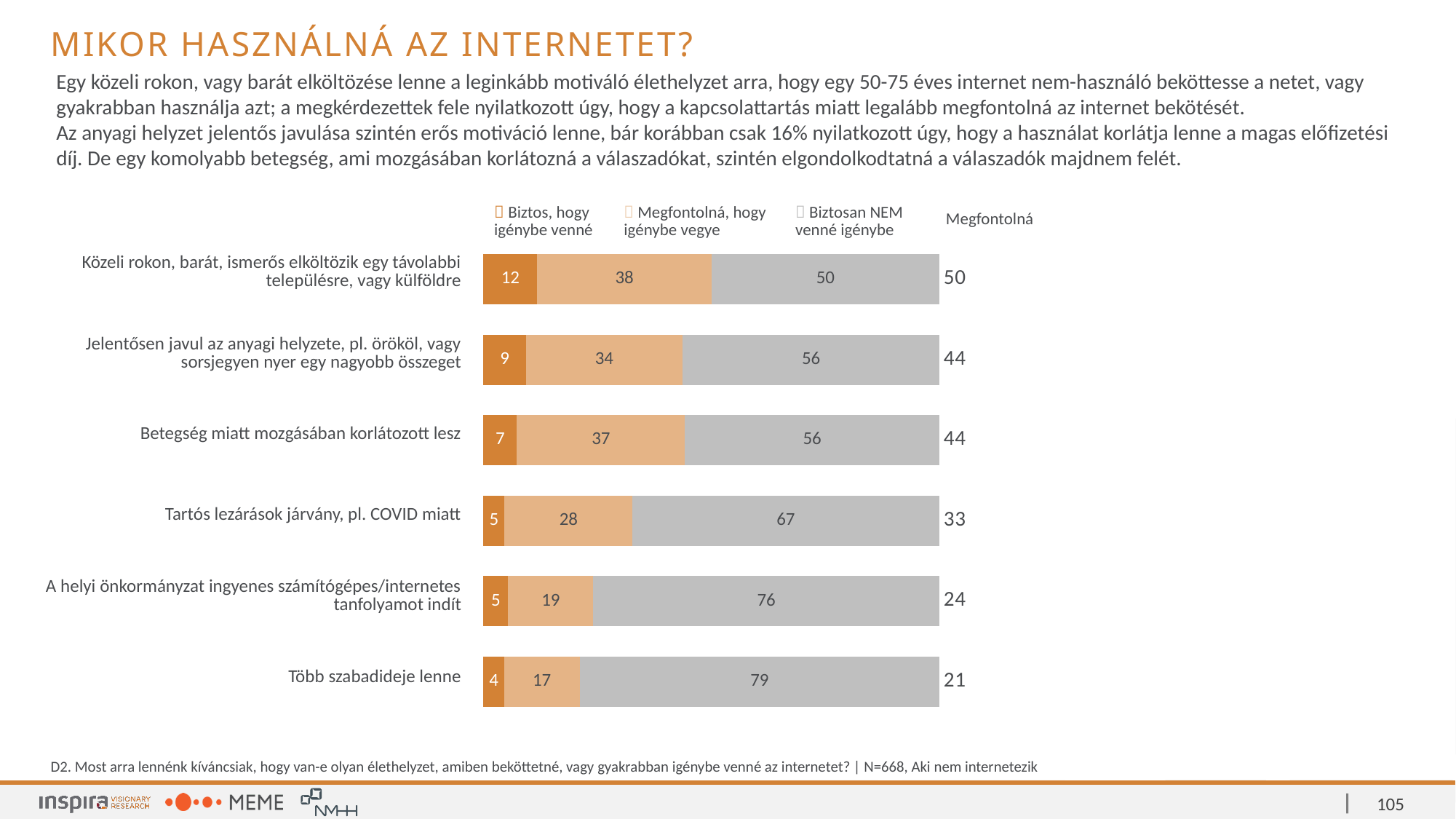
What is the 'Biztosan NEM venné igénybe' value for 'Tartós lezárások járvány, pl. COVID miatt'? 67 How many categories (life situations) are shown in the chart? 6 What is the 'Megfontolná' total shown to the right of the bar for 'A helyi önkormányzat ingyenes számítógépes/internetes tanfolyamot indít'? 24 What kind of chart is shown on the slide? Stacked bar chart What is the title of the slide containing the chart? MIKOR HASZNÁLNÁ AZ INTERNETET? What is the difference between the 'Biztosan NEM venné igénybe' values for 'Több szabadideje lenne' and 'Közeli rokon, barát, ismerős elköltözik egy távolabbi településre, vagy külföldre'? 29 What is the 'Megfontolná, hogy igénybe vegye' value for 'Több szabadideje lenne'? 17 Which is larger: the 'Megfontolná, hogy igénybe vegye' value for 'Betegség miatt mozgásában korlátozott lesz' or for 'Jelentősen javul az anyagi helyzete, pl. örököl, vagy sorsjegyen nyer egy nagyobb összeget'? Betegség miatt mozgásában korlátozott lesz Which category has the highest 'Biztosan NEM venné igénybe' value? Több szabadideje lenne What is the 'Biztos, hogy igénybe venné' value for 'Közeli rokon, barát, ismerős elköltözik egy távolabbi településre, vagy külföldre'? 12 Which category has the lowest 'Megfontolná, hogy igénybe vegye' value? Több szabadideje lenne How many series does the legend list? 3